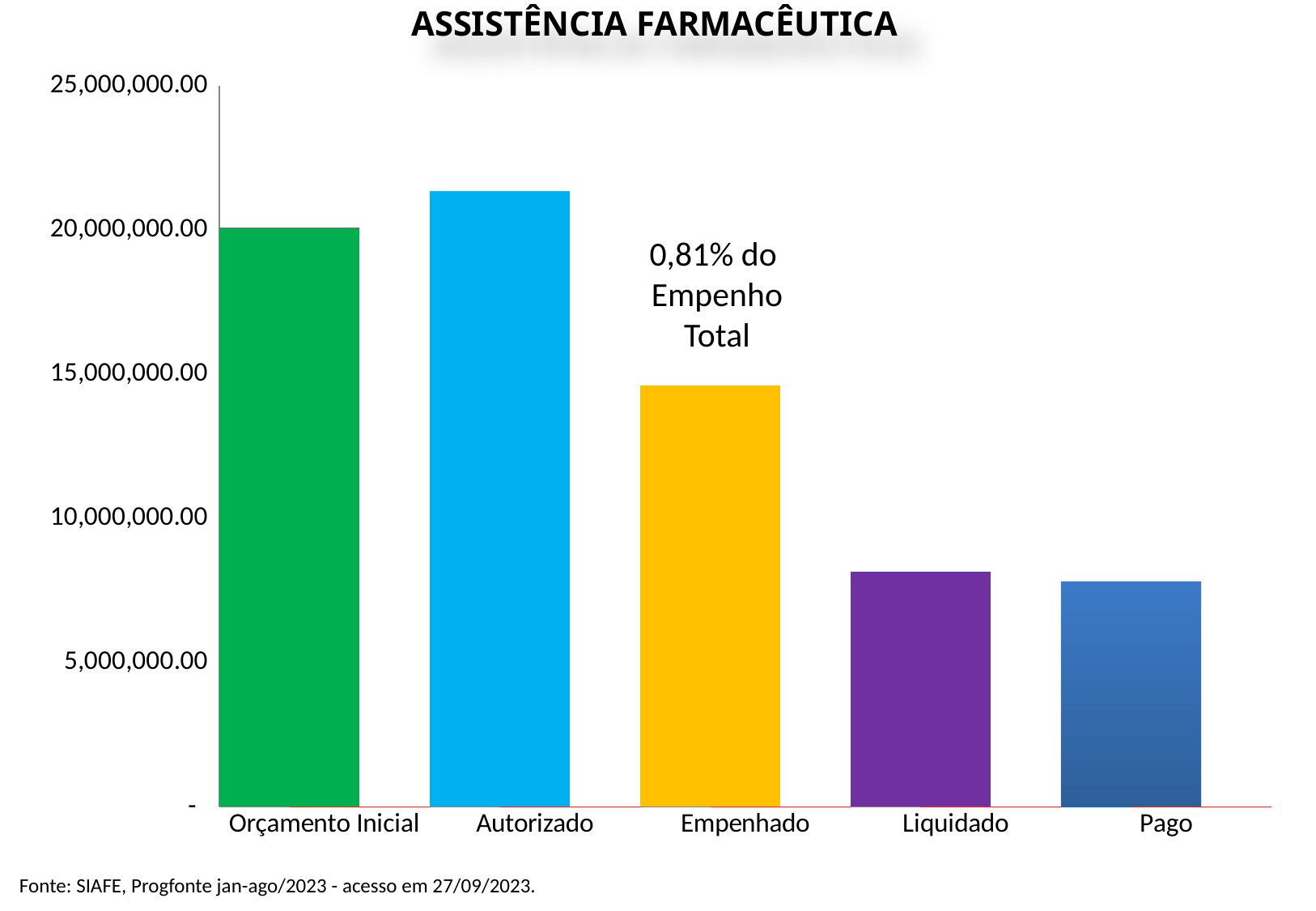
Is the value for Pago greater or less than 5,000,000.00? greater What text annotation is shown above the Empenhado bar? 0,81% do Empenho Total How many categories are shown on the x axis of the chart? 5 Which category has the highest bar in the chart? Autorizado What is the title of the chart? ASSISTÊNCIA FARMACÊUTICA Is the value for Autorizado greater or less than 20,000,000.00? greater Is the value for Liquidado greater or less than 10,000,000.00? less Do the values rise or fall from Autorizado to Pago along the x axis? fall Which is larger, the value for Liquidado or the value for Pago? Liquidado Which category has the lowest bar in the chart? Pago What kind of chart is shown on the slide? bar chart